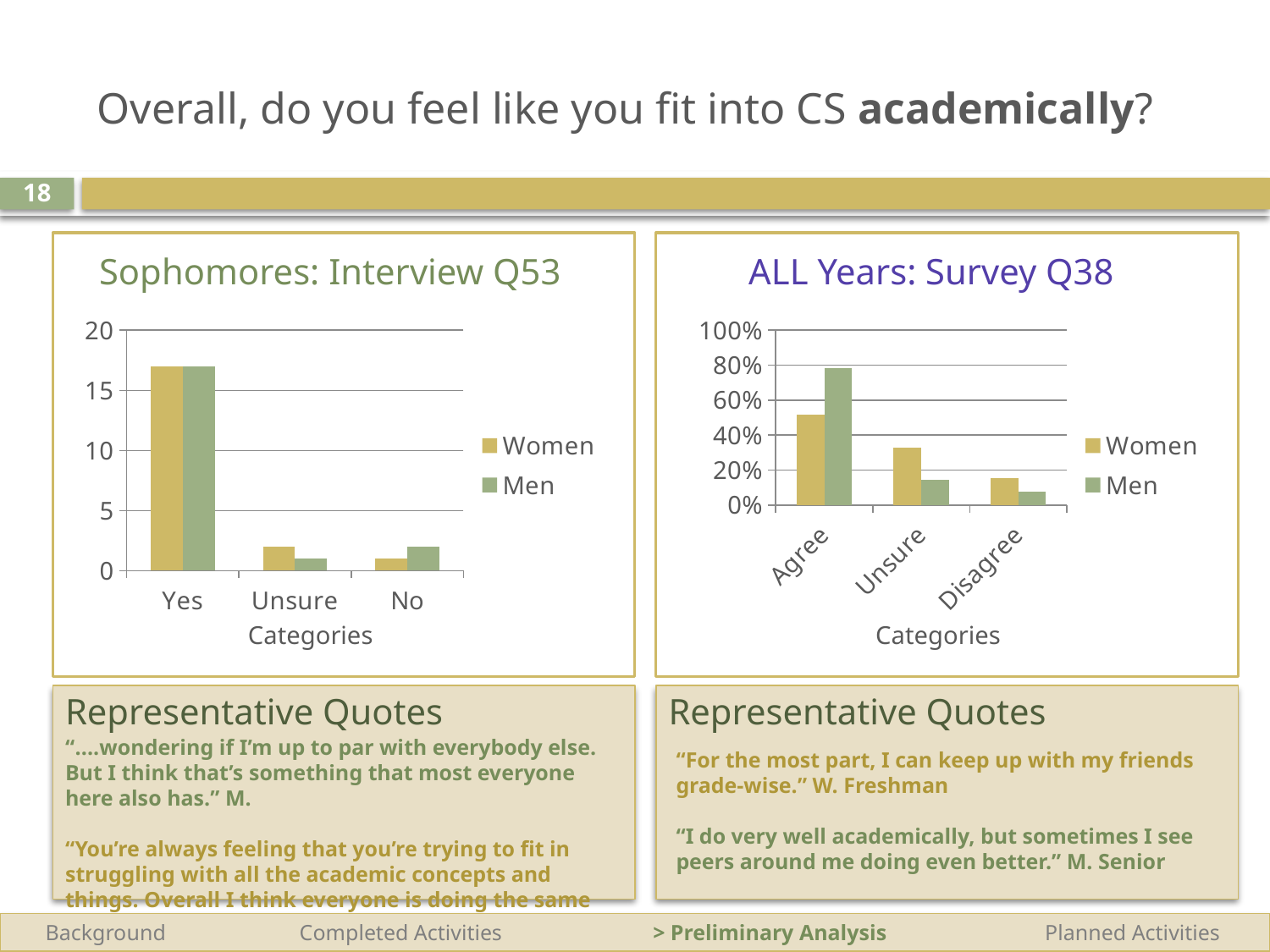
In the 'Sophomores: Interview Q53' chart, is the value for Women in the Yes category greater or less than 15? greater How many series does the legend of the 'Sophomores: Interview Q53' chart list? 2 How many categories are shown on the x axis of the 'ALL Years: Survey Q38' chart? 3 How many categories are shown on the x axis of the 'Sophomores: Interview Q53' chart? 3 In the 'Sophomores: Interview Q53' chart, which is larger in the No category, Women or Men? Men What is the title of the chart on the right side of the slide? ALL Years: Survey Q38 In the 'ALL Years: Survey Q38' chart, which is larger in the Unsure category, Women or Men? Women In the 'Sophomores: Interview Q53' chart, which category has the highest value for Women? Yes What kind of chart is the 'Sophomores: Interview Q53' chart? bar chart In the 'Sophomores: Interview Q53' chart, is the value for Men in the Unsure category greater or less than 5? less In the 'ALL Years: Survey Q38' chart, which category has the highest value for Men? Agree In the 'ALL Years: Survey Q38' chart, is the value for Men in the Agree category greater or less than 60%? greater